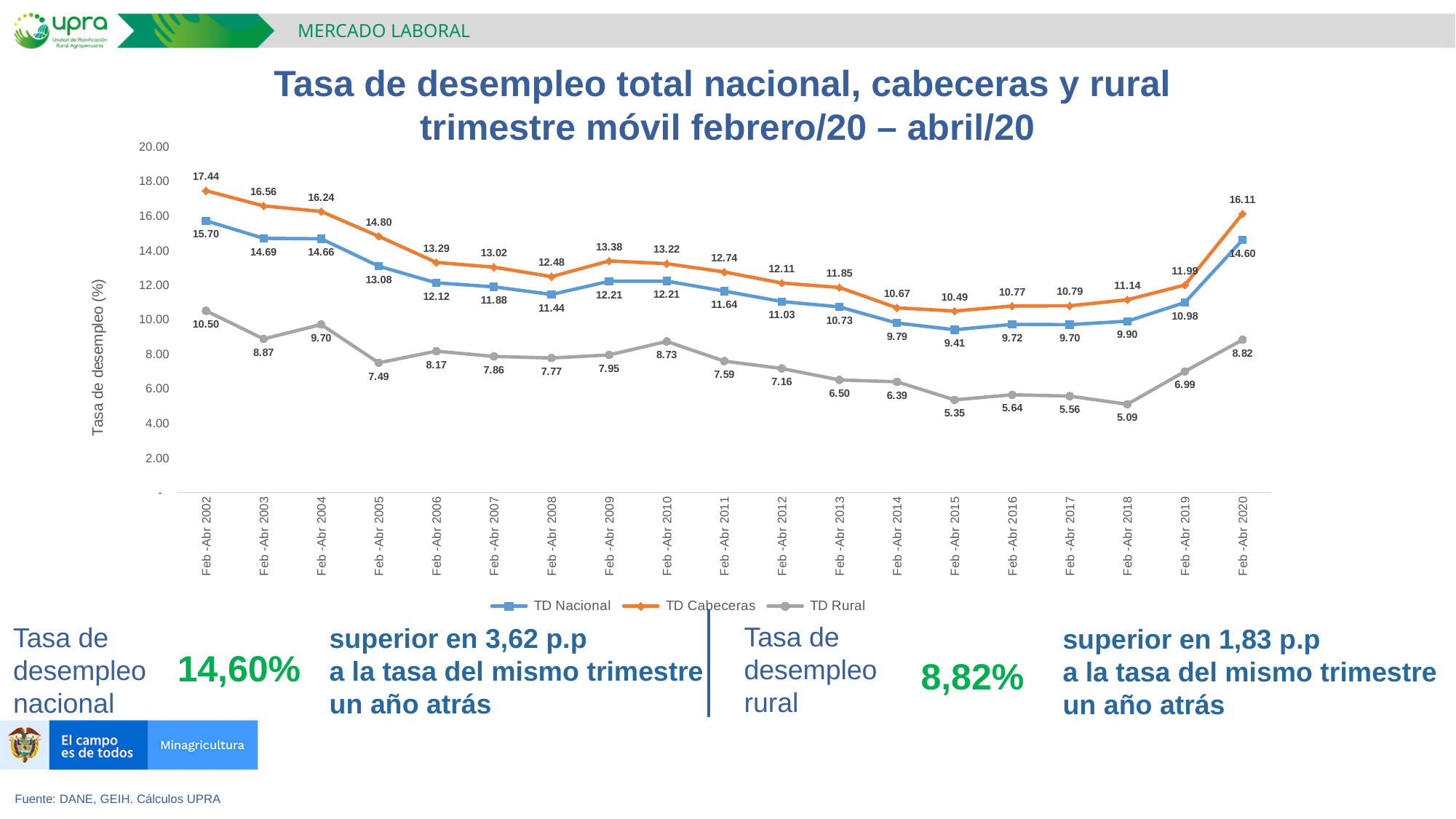
How many periods are shown on the x axis? 19 Which is larger, TD Rural in Feb-Abr 2010 or in Feb-Abr 2020? Feb-Abr 2020 What kind of chart is shown on the slide? Line chart What is the value of TD Cabeceras for Feb-Abr 2002? 17.44 In which period is TD Rural lowest? Feb-Abr 2018 How many series does the legend list? 3 What is the value of TD Rural for Feb-Abr 2018? 5.09 In which period is TD Nacional lowest? Feb-Abr 2015 What is the difference between TD Nacional in Feb-Abr 2020 and Feb-Abr 2019? 3.62 In which period is TD Cabeceras highest? Feb-Abr 2002 What is the value of TD Nacional for Feb-Abr 2020? 14.60 What is the difference between TD Rural in Feb-Abr 2020 and Feb-Abr 2019? 1.83